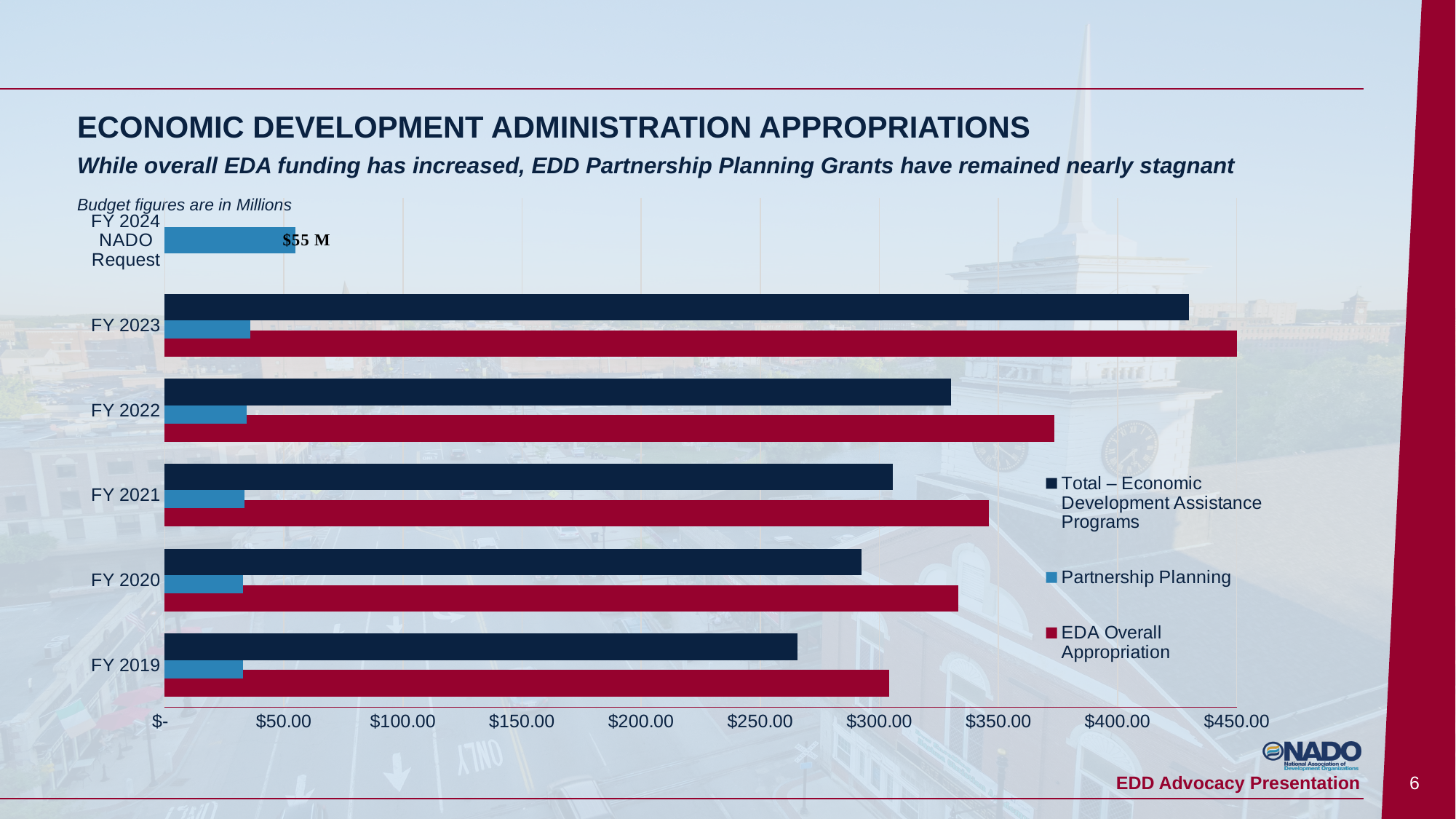
Which is larger, the EDA Overall Appropriation for FY 2022 or for FY 2021? FY 2022 Is the Partnership Planning value for FY 2020 greater or less than $50.00? less What is the Partnership Planning value for the FY 2024 NADO Request? $55 M Is the Total – Economic Development Assistance Programs value for FY 2019 greater or less than $300.00? less Does the EDA Overall Appropriation rise or fall from FY 2019 to FY 2023? Rises Is the EDA Overall Appropriation for FY 2023 greater or less than $400.00? greater How many fiscal year categories are shown on the chart? 6 How many series does the chart legend list? 3 What kind of chart is shown on the slide? Bar chart What unit are the budget figures in, according to the note above the chart? Millions Which fiscal year has the highest EDA Overall Appropriation? FY 2023 Which fiscal year has the lowest Total – Economic Development Assistance Programs value? FY 2019